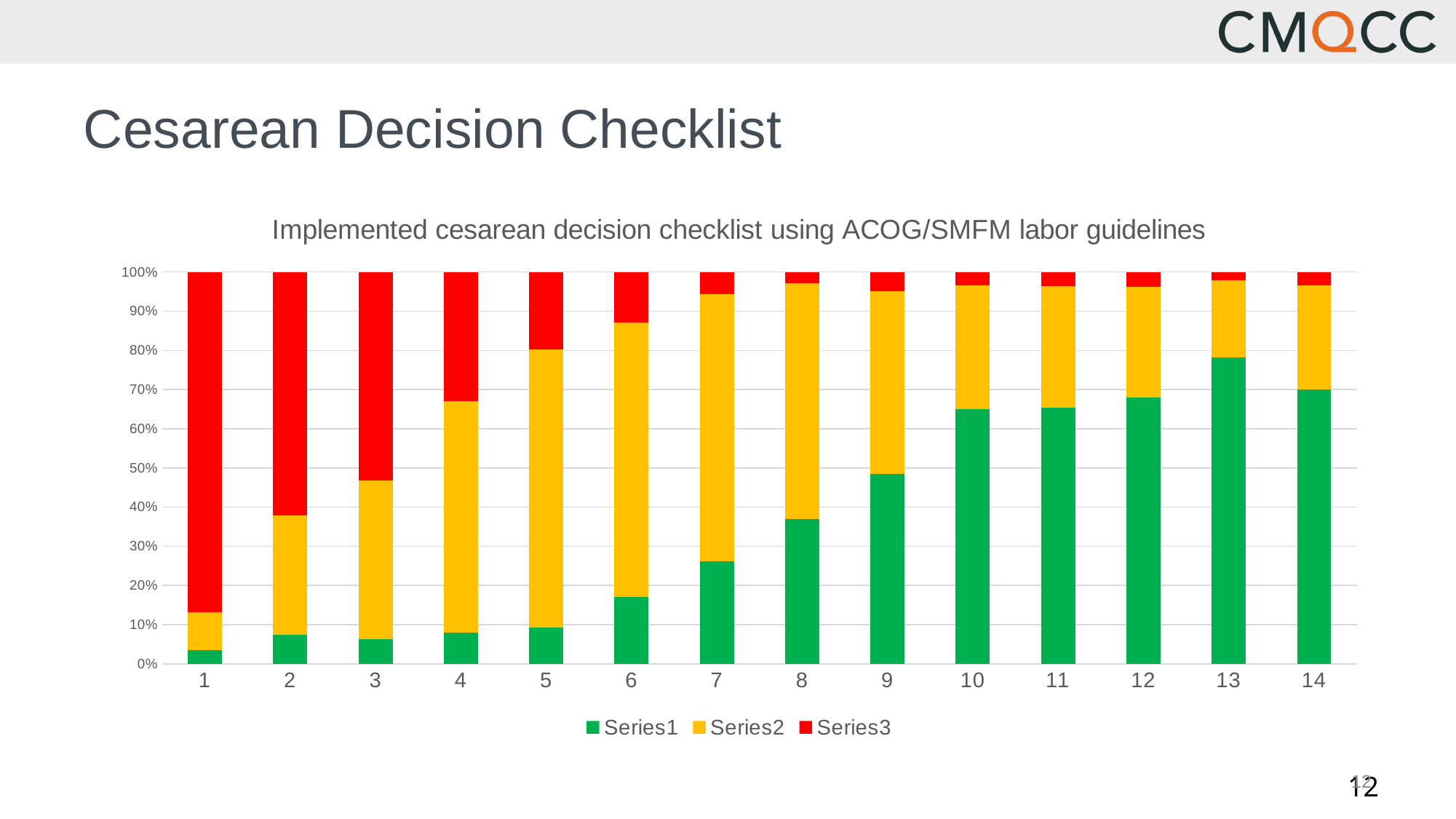
Which category has the larger Series1 (green) share, category 2 or category 10? 10 In which category is the Series3 (red) share the largest? 1 Does the Series3 (red) share rise or fall as you move from category 1 to category 14? Fall In which category is the Series1 (green) share the highest? 13 Which colour represents Series3 in the chart? Red Is the Series1 (green) value for category 8 greater or less than 40%? less What kind of chart is shown on the slide? Stacked bar chart Does the Series1 (green) share rise or fall as you move from category 1 to category 14? Rise How many series does the chart's legend list? 3 Is the Series1 (green) value for category 13 greater or less than 70%? greater What is the title of the chart? Implemented cesarean decision checklist using ACOG/SMFM labor guidelines How many categories are shown along the x axis of the chart? 14